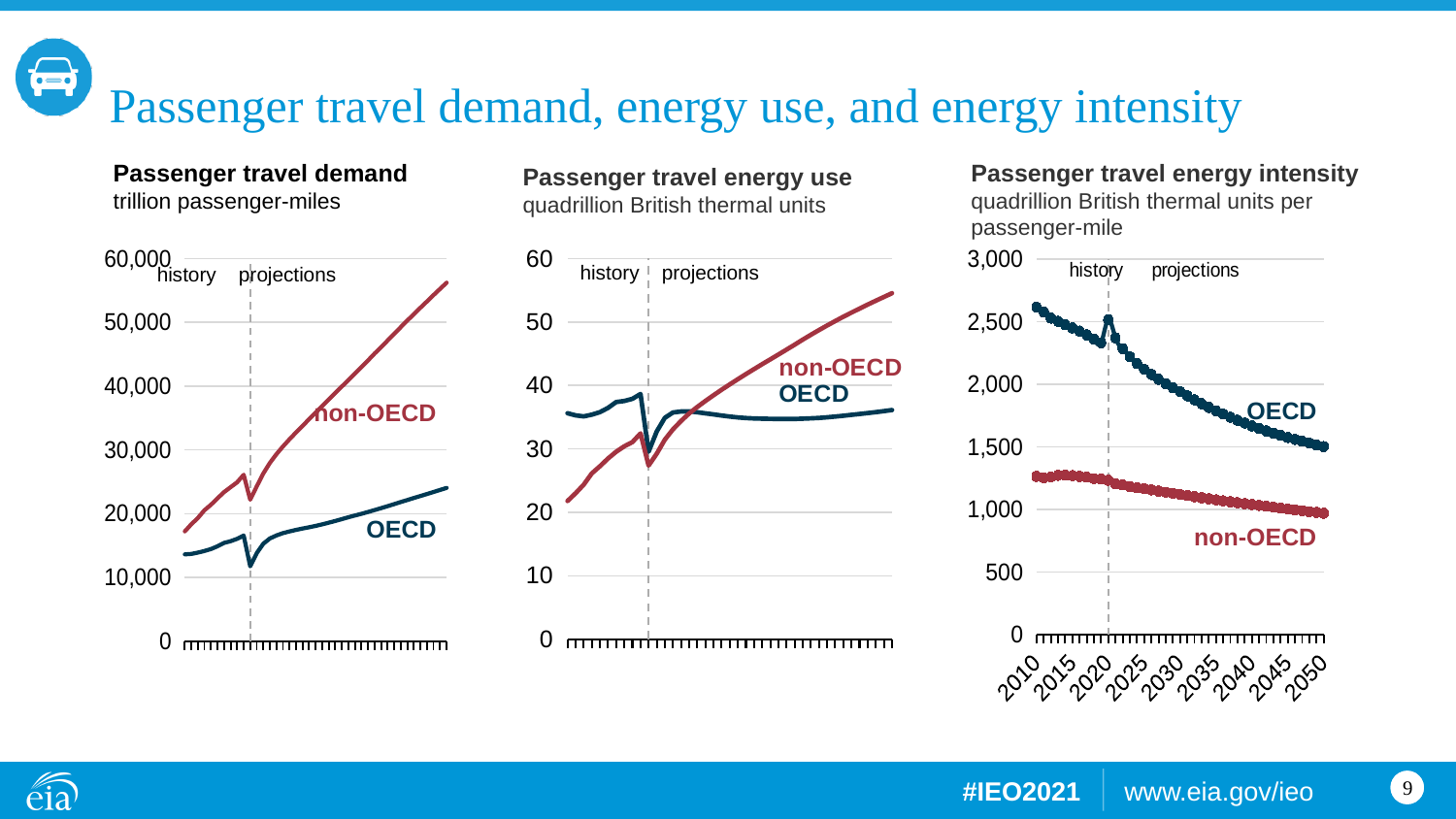
On the Passenger travel demand chart, is the non-OECD value at the end of the projection period greater or less than 50,000? greater What unit is shown under the title of the Passenger travel energy intensity chart? quadrillion British thermal units per passenger-mile On the Passenger travel energy intensity chart, which series is higher in 2050, OECD or non-OECD? OECD On the Passenger travel demand chart, does the non-OECD series rise or fall over the projection period? rise On the Passenger travel energy intensity chart, does the OECD series rise or fall from 2010 to 2050? fall On the Passenger travel energy use chart, is the OECD value at the end of the projection period greater or less than 40? less How many series are plotted on the Passenger travel energy use chart? 2 On the Passenger travel demand chart, is the OECD value at the end of the projection period greater or less than 30,000? less What kind of chart is the Passenger travel demand chart? line chart On the Passenger travel energy use chart, which series is higher at the end of the projection period, OECD or non-OECD? non-OECD